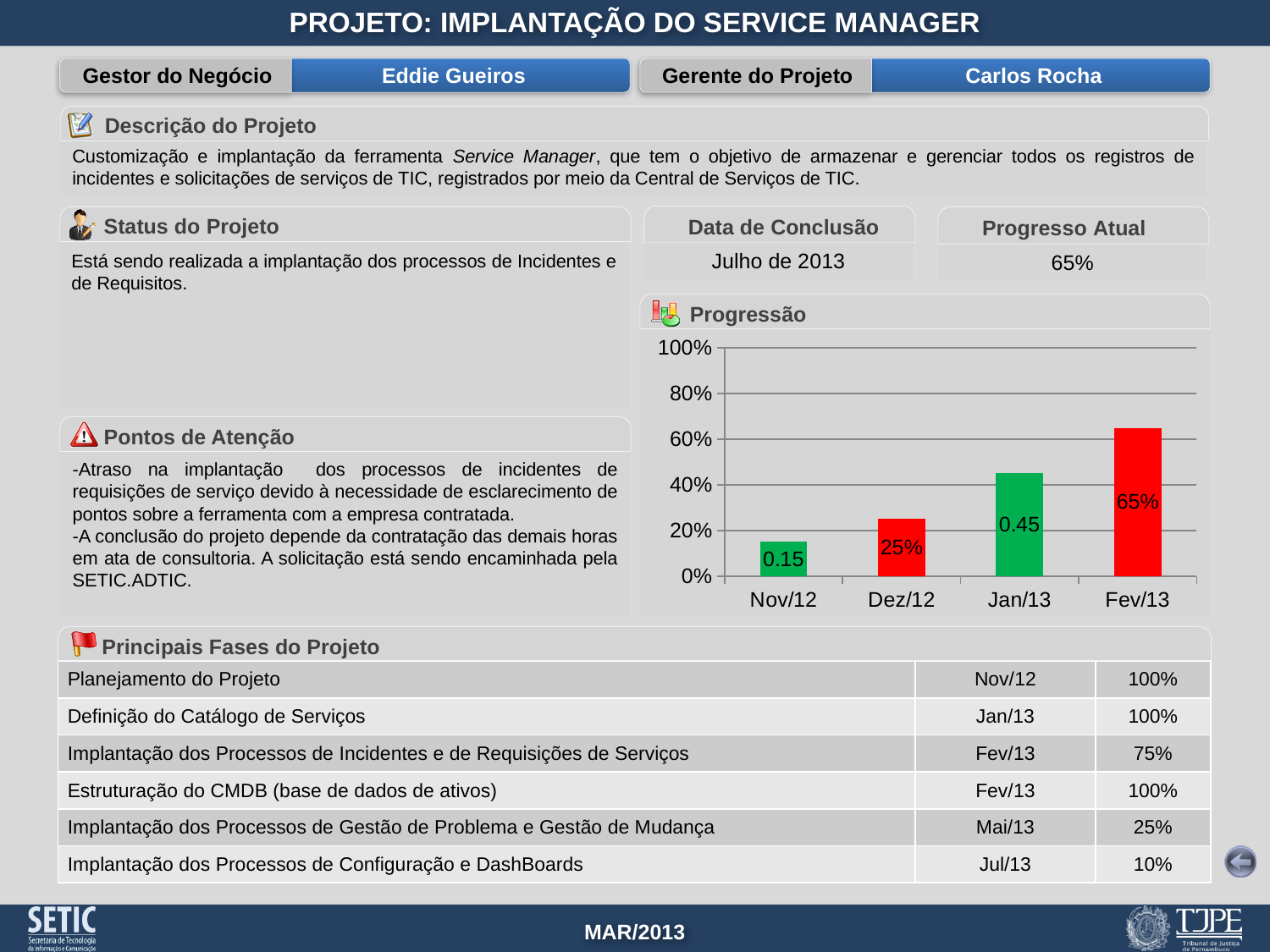
What is the value shown for Dez/12 in the Progressão chart? 25% Do the values in the Progressão chart rise or fall from Nov/12 to Fev/13? rise What is the value shown for Jan/13 in the Progressão chart? 0.45 What kind of chart is the Progressão chart? bar chart Which month has the lowest bar in the Progressão chart? Nov/12 How many months are plotted in the Progressão chart? 4 In the Progressão chart, is the value for Fev/13 greater or less than 60%? greater Which month has the highest bar in the Progressão chart? Fev/13 What is the value shown for Fev/13 in the Progressão chart? 65% In the Progressão chart, which is larger: the value for Jan/13 or the value for Dez/12? Jan/13 What is the value shown for Nov/12 in the Progressão chart? 0.15 In the Progressão chart, what is the difference between the Fev/13 value and the Dez/12 value? 40%